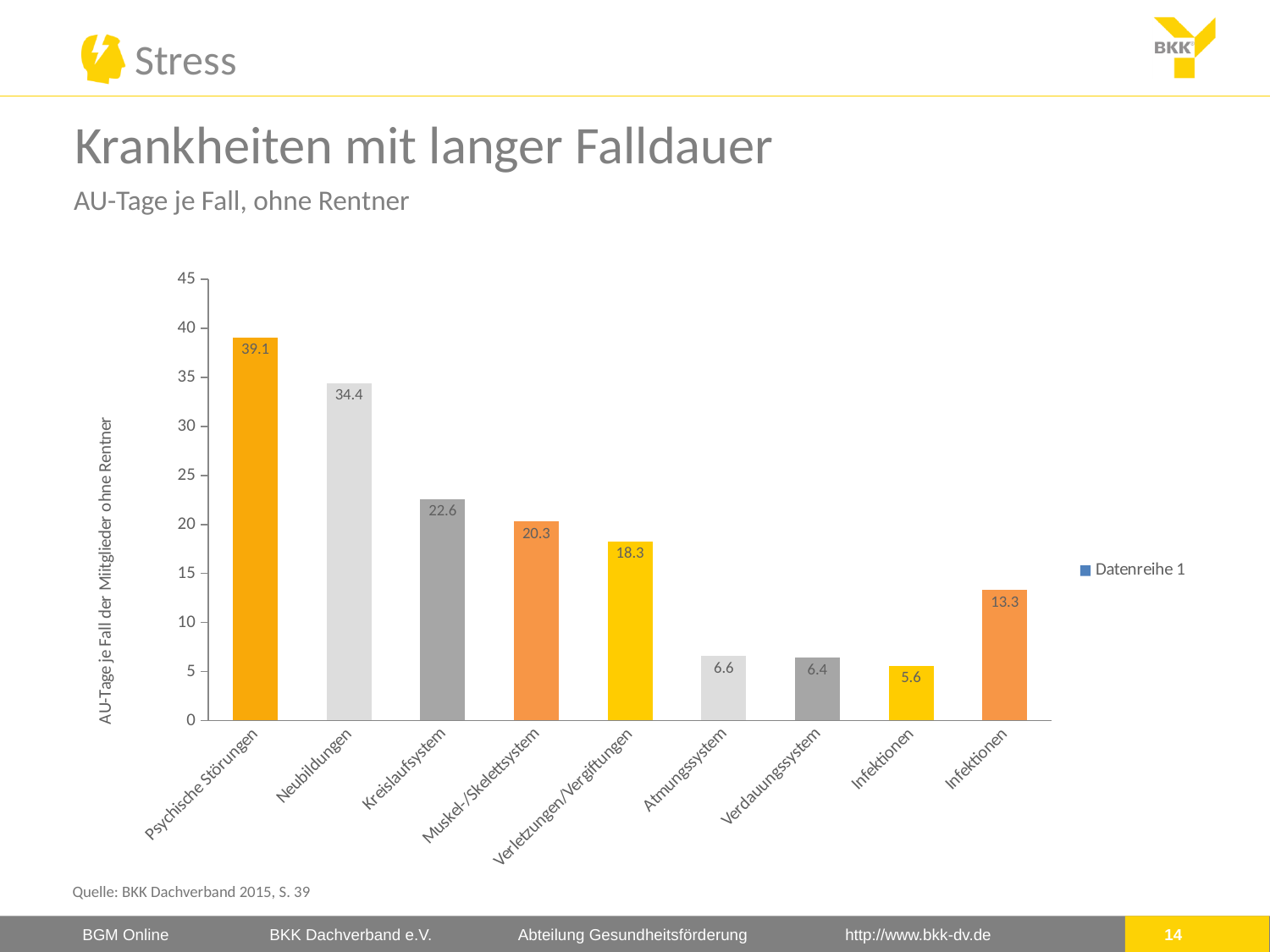
Which is larger, the value for Atmungssystem or the value for Verdauungssystem? Atmungssystem What is the title of the chart on the slide? Krankheiten mit langer Falldauer What is the value for Kreislaufsystem? 22.6 What kind of chart is shown on the slide? bar chart What is the value for Psychische Störungen? 39.1 What is the value for Verletzungen/Vergiftungen? 18.3 How many series does the legend list? 1 How many bars are shown in the chart? 9 Which category has the highest value? Psychische Störungen What is the difference between the values for Psychische Störungen and Neubildungen? 4.7 What is the value for Neubildungen? 34.4 Is the value for Muskel-/Skelettsystem greater or less than 25? less